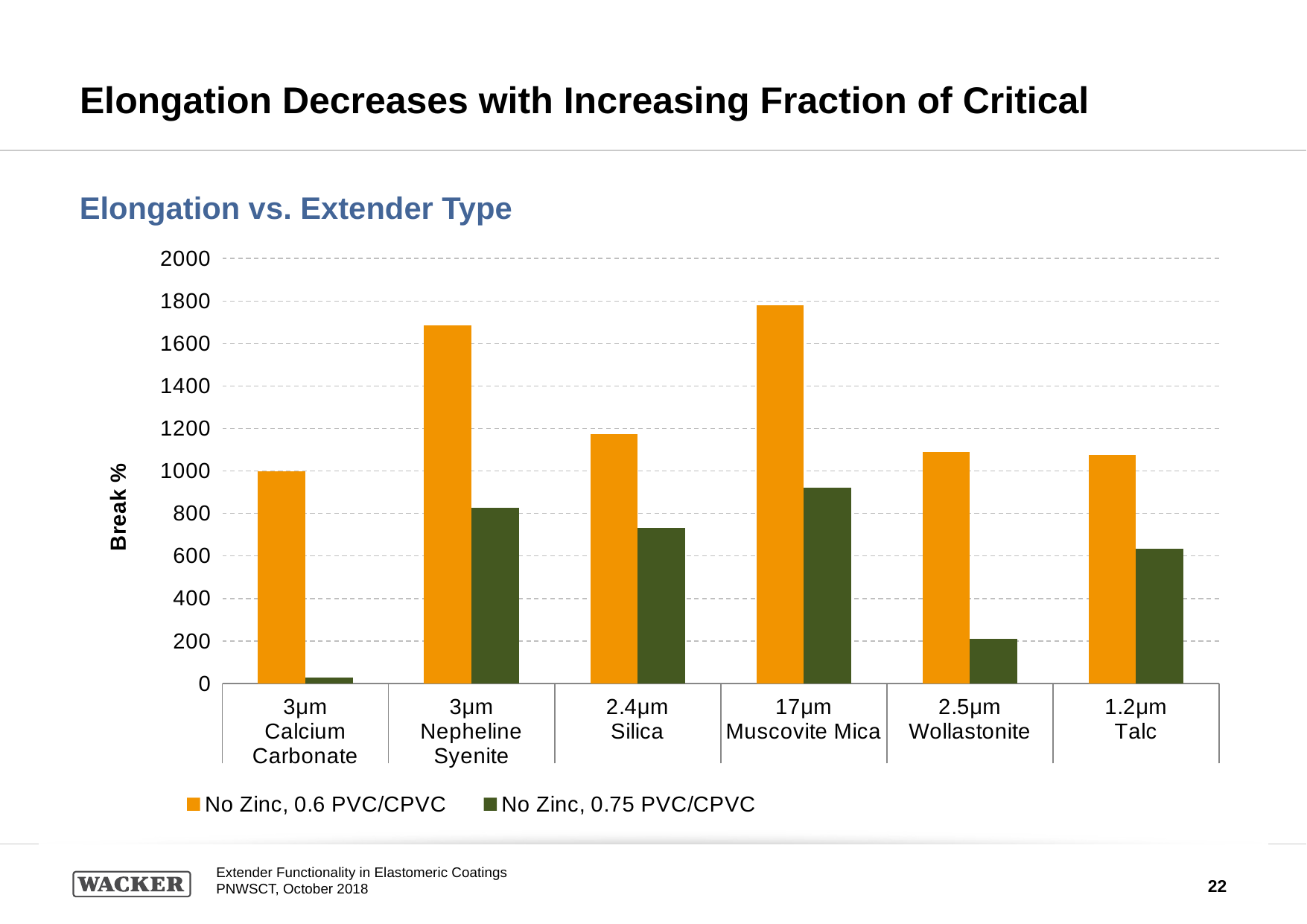
Which extender has the lowest value for the No Zinc, 0.75 PVC/CPVC series? 3µm Calcium Carbonate Which extender has the highest value for the No Zinc, 0.6 PVC/CPVC series? 17µm Muscovite Mica Which extender has the highest value for the No Zinc, 0.75 PVC/CPVC series? 17µm Muscovite Mica Is the No Zinc, 0.6 PVC/CPVC value for 3µm Nepheline Syenite greater or less than 1600? greater Is the No Zinc, 0.75 PVC/CPVC value for 2.5µm Wollastonite greater or less than 400? less For the No Zinc, 0.75 PVC/CPVC series, which is larger: 3µm Nepheline Syenite or 2.4µm Silica? 3µm Nepheline Syenite How many extender types are shown on the x axis? 6 What kind of chart is shown on the slide? bar chart How many series does the legend list? 2 What is the label on the vertical axis of the chart? Break % Is the No Zinc, 0.75 PVC/CPVC value for 3µm Calcium Carbonate greater or less than 200? less